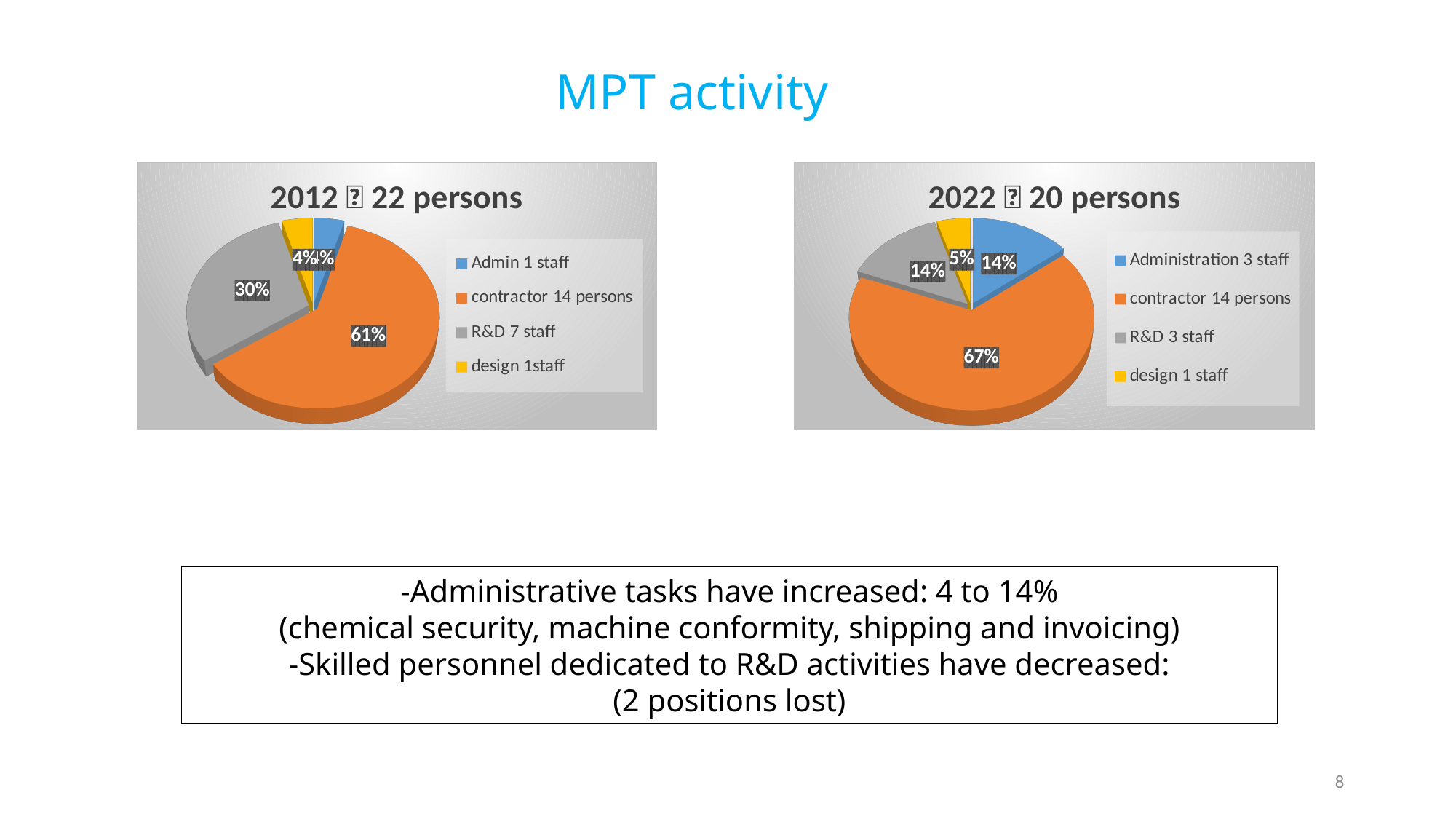
In the 2022 pie chart, what share is shown for contractor 14 persons? 67% What type of chart is used on this slide? Pie chart In the 2022 pie chart, what share is shown for design 1 staff? 5% In the 2022 pie chart, which category has the smallest slice? design 1 staff According to the title of the right-hand pie chart, how many persons were there in 2022? 20 persons In the 2012 pie chart, what share is shown for R&D 7 staff? 30% In the 2022 pie chart, what share is shown for Administration 3 staff? 14% How many categories does the legend of the 2012 pie chart list? 4 In the 2012 pie chart, which category has the largest slice? contractor 14 persons Is the R&D share larger in the 2012 pie chart or the 2022 pie chart? 2012 In the 2022 pie chart, what is the difference between the contractor share and the design share? 62% In the 2012 pie chart, what share is shown for contractor 14 persons? 61%